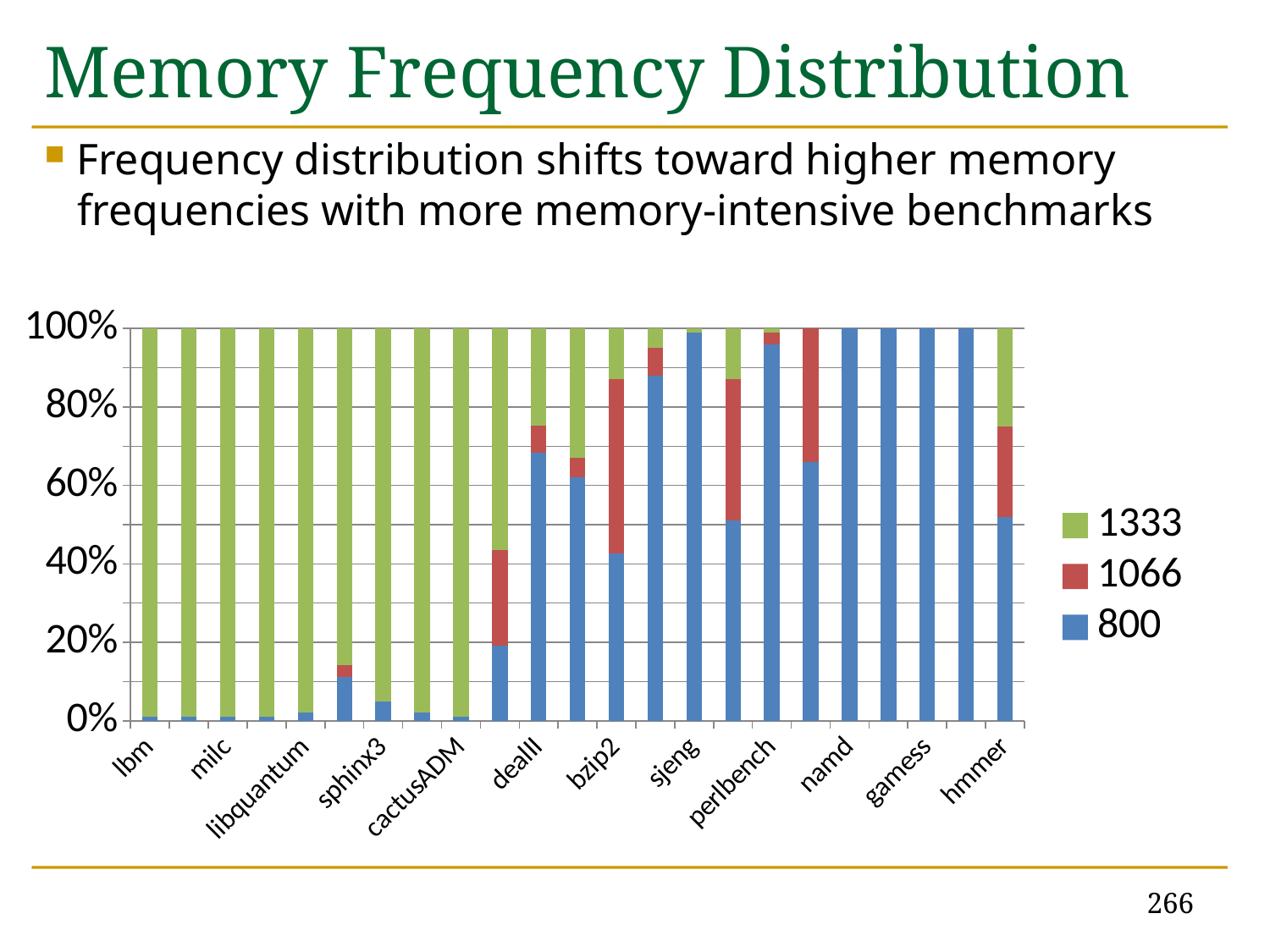
Is the 1333 share for lbm greater or less than 80%? greater Is the 800 share for namd greater or less than 80%? greater How many series does the legend list? 3 Moving from left to right along the x axis, does the share of the 800 series generally rise or fall? Rise Which benchmark has a larger 800 share, lbm or namd? namd Is the 800 share for bzip2 greater or less than 60%? less What are the three series named in the legend? 1333, 1066, 800 What kind of chart is shown on the slide? Stacked bar chart Which colour represents the 800 series in the legend? Blue Which benchmark has a larger 1333 share, milc or gamess? milc